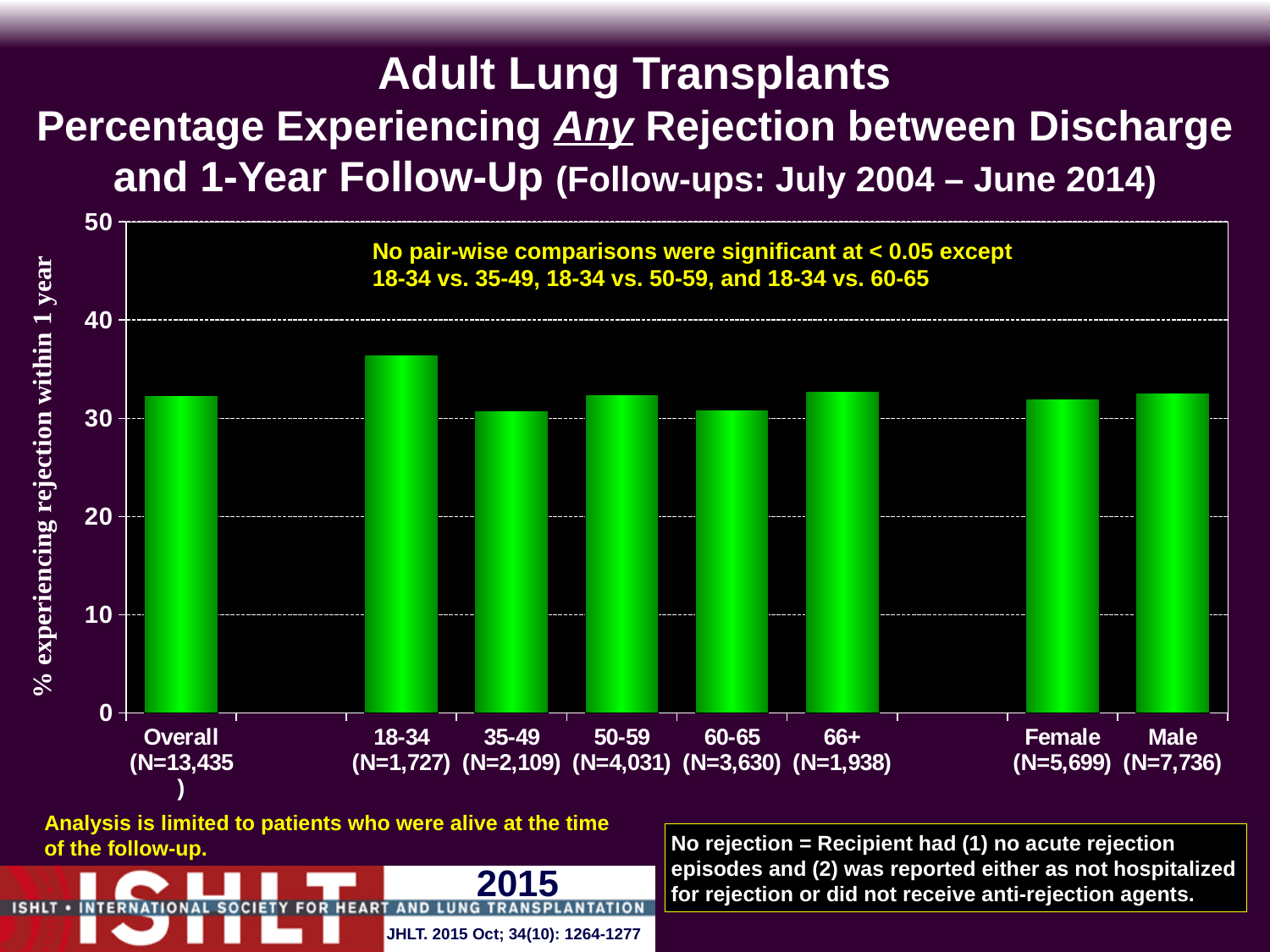
What is the sample size (N) shown for the Male category? N=7,736 Is the value for Overall greater or less than 30? greater Is the value for the 66+ age group greater or less than 30? greater Which has a higher percentage experiencing rejection, the 18-34 group or the 35-49 group? 18-34 Is the value for the 18-34 age group greater or less than 40? less What is the label of the y-axis? % experiencing rejection within 1 year Which category has the highest percentage experiencing rejection within 1 year? 18-34 Which has a higher percentage experiencing rejection, the 18-34 group or Overall? 18-34 How many categories (bars) are plotted in the chart? 8 What kind of chart is shown on the slide? bar chart